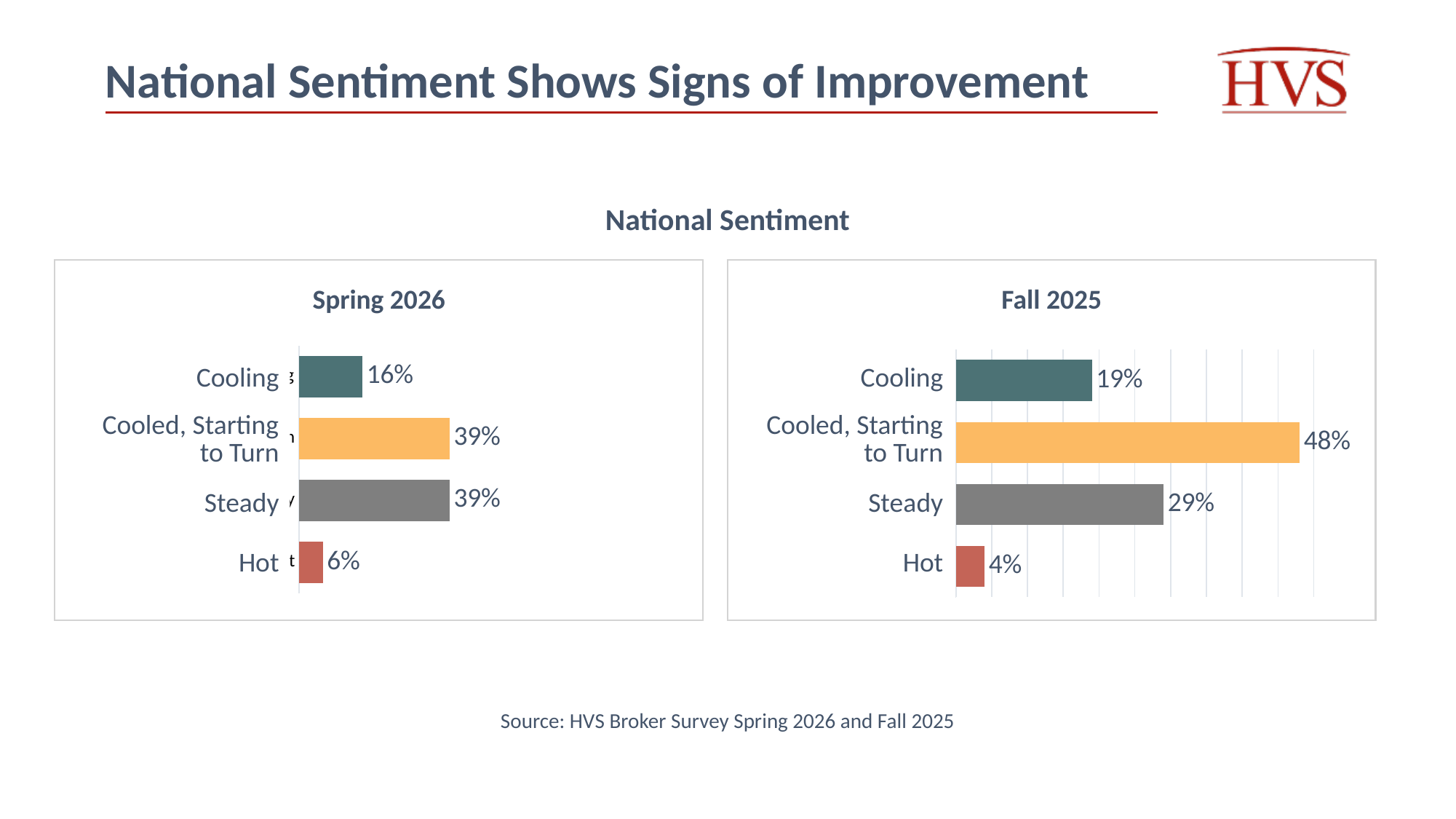
What kind of chart is the Fall 2025 chart? Bar chart In the Spring 2026 chart, what is the value for Hot? 6% In the Fall 2025 chart, which category has the highest value? Cooled, Starting to Turn In the Fall 2025 chart, what is the value for Cooled, Starting to Turn? 48% In the Fall 2025 chart, what is the difference between Cooled, Starting to Turn and Steady? 19% What is the difference between the Cooling values in Fall 2025 and Spring 2026? 3% What is the title shown above the two charts? National Sentiment In the Spring 2026 chart, what is the value for Cooling? 16% Which is larger: Steady in Spring 2026 or Steady in Fall 2025? Steady in Spring 2026 How many categories does the Spring 2026 chart show? 4 In the Spring 2026 chart, which category has the lowest value? Hot In the Fall 2025 chart, what is the value for Steady? 29%